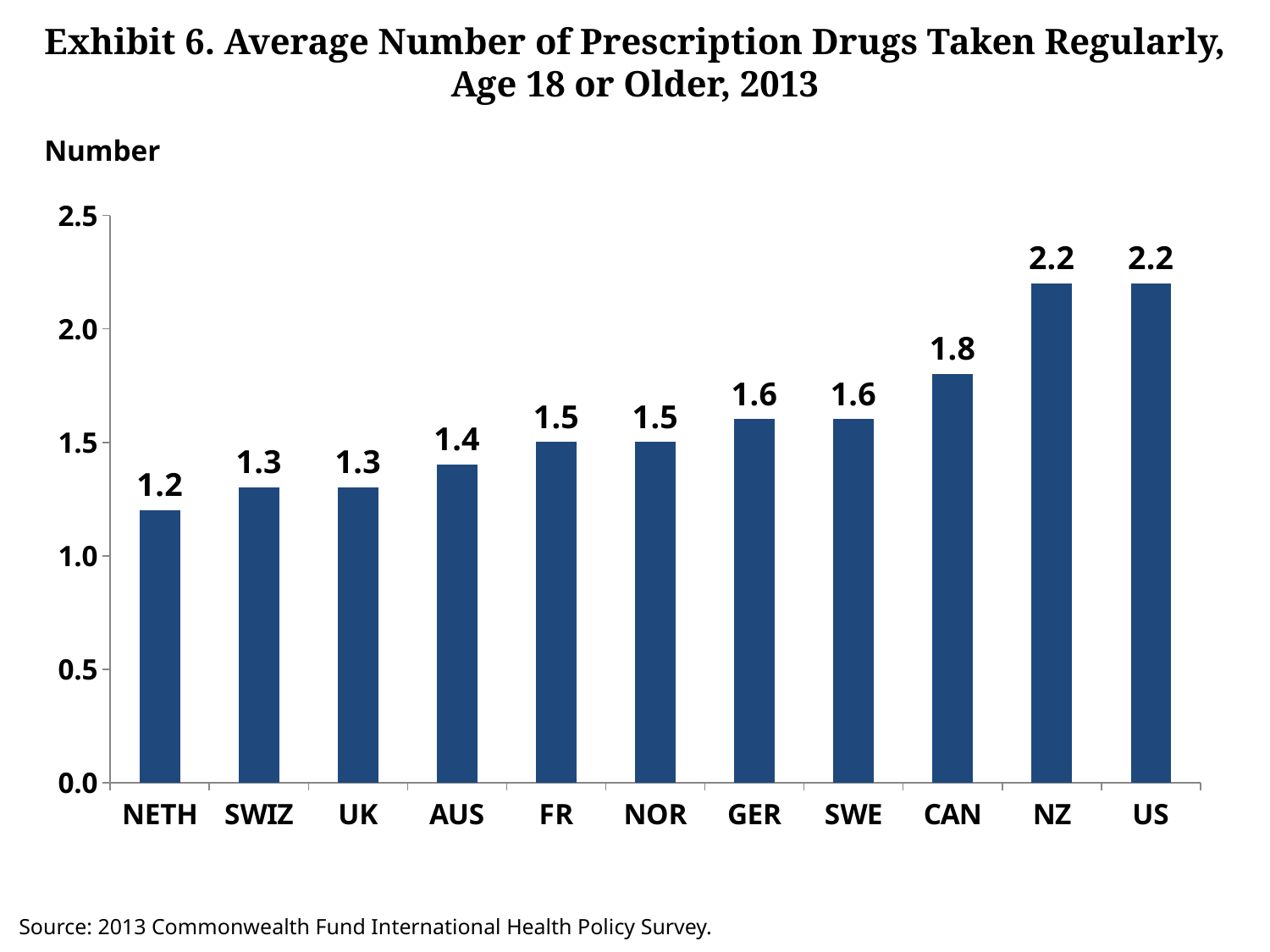
What kind of chart is this? bar chart Which is larger, the value for CAN or the value for FR? CAN What is the value for AUS? 1.4 What is the value for NETH? 1.2 What is the difference between the values for US and NETH? 1.0 What is the difference between the values for CAN and GER? 0.2 Is the value for NZ greater or less than 2.0? greater Which country has the lowest value? NETH How many countries are shown on the chart? 11 What is the value for CAN? 1.8 What is the label on the vertical axis? Number Do the values rise or fall from left to right along the x axis? rise